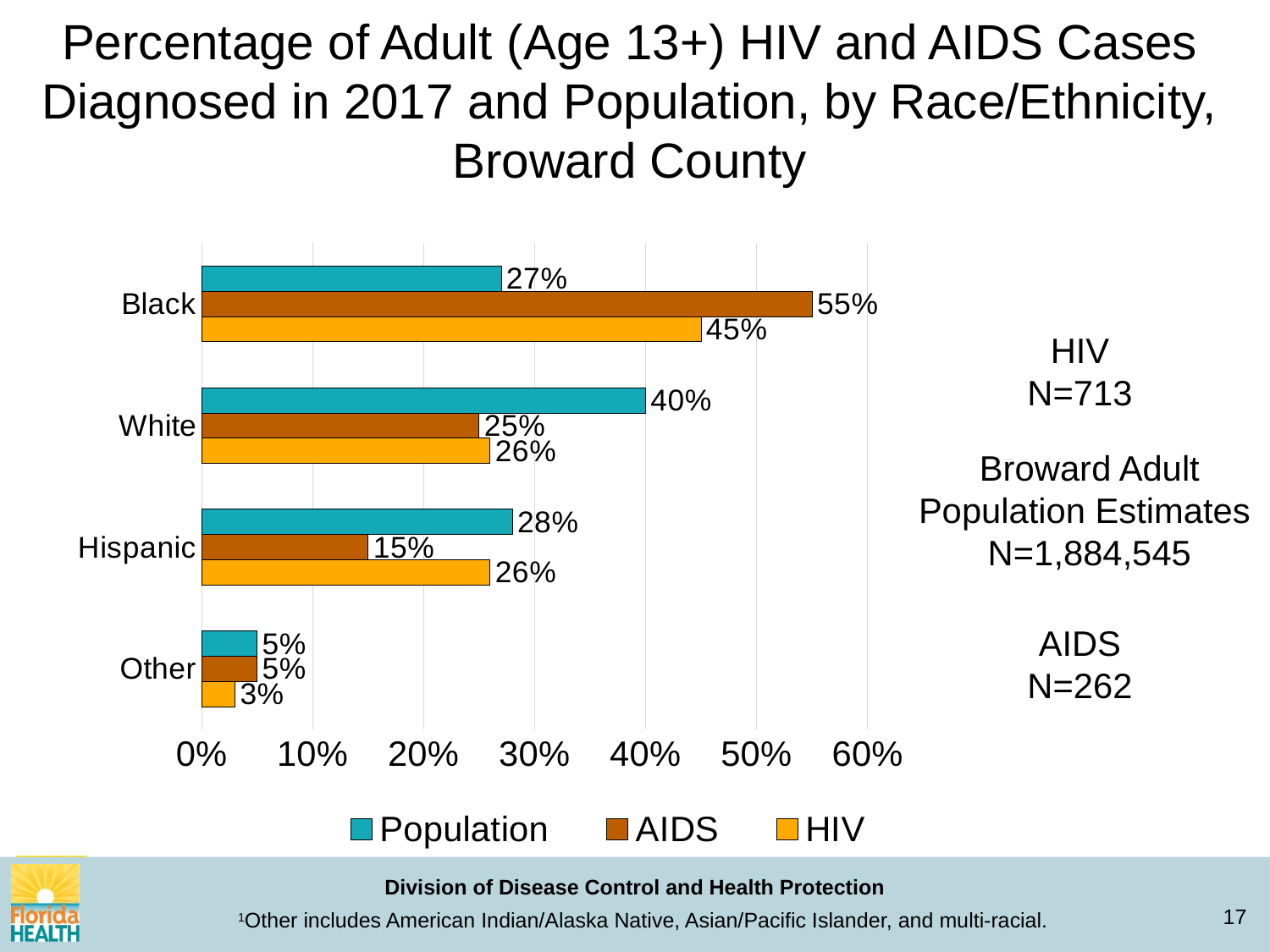
How many series does the legend list? 3 Which race/ethnicity has the highest AIDS percentage? Black What is the AIDS percentage for Black? 55% Which is larger for Hispanic, the Population percentage or the AIDS percentage? Population What is the N for HIV cases shown on the slide? 713 What is the HIV percentage for Hispanic? 26% What kind of chart is shown on the slide? Bar chart What is the Population percentage for White? 40% How many race/ethnicity categories are shown on the chart? 4 What is the HIV percentage for Other? 3% Which race/ethnicity has the lowest HIV percentage? Other What is the difference between the AIDS and Population percentages for Black? 28%